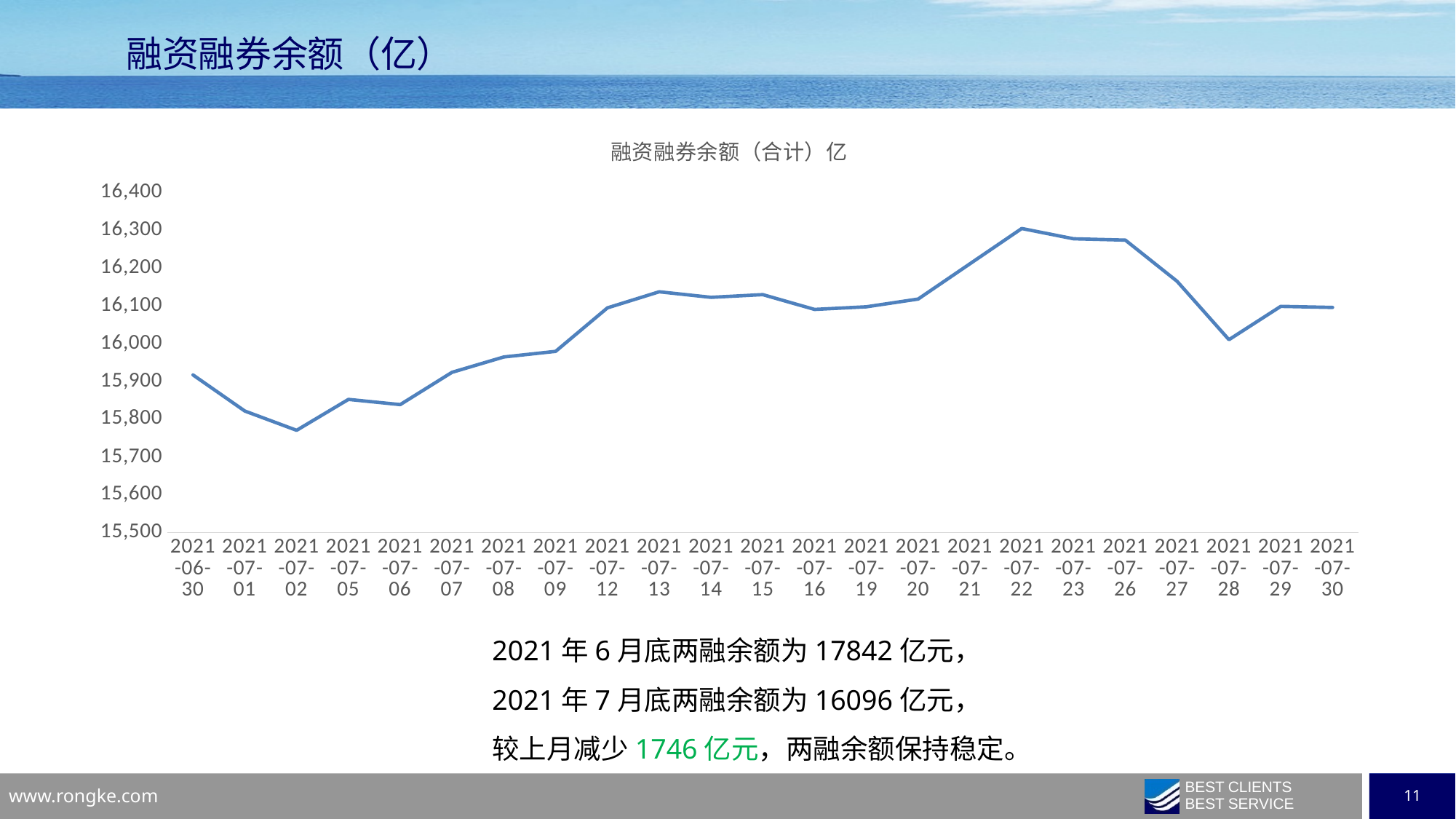
Is the value for 2021-07-02 greater or less than 15,800? less Is the value for 2021-07-12 greater or less than 16,000? greater Which date has the larger value, 2021-07-01 or 2021-07-09? 2021-07-09 Does the line rise or fall from 2021-07-22 to 2021-07-28? fall What kind of chart is shown on the slide? line chart On which date does the line reach its lowest value? 2021-07-02 On which date does the line reach its highest value? 2021-07-22 Which date has the larger value, 2021-07-26 or 2021-07-28? 2021-07-26 Is the value for 2021-07-22 greater or less than 16,200? greater What is the title of the chart? 融资融券余额（合计）亿 How many dates are plotted on the x axis of the chart? 23